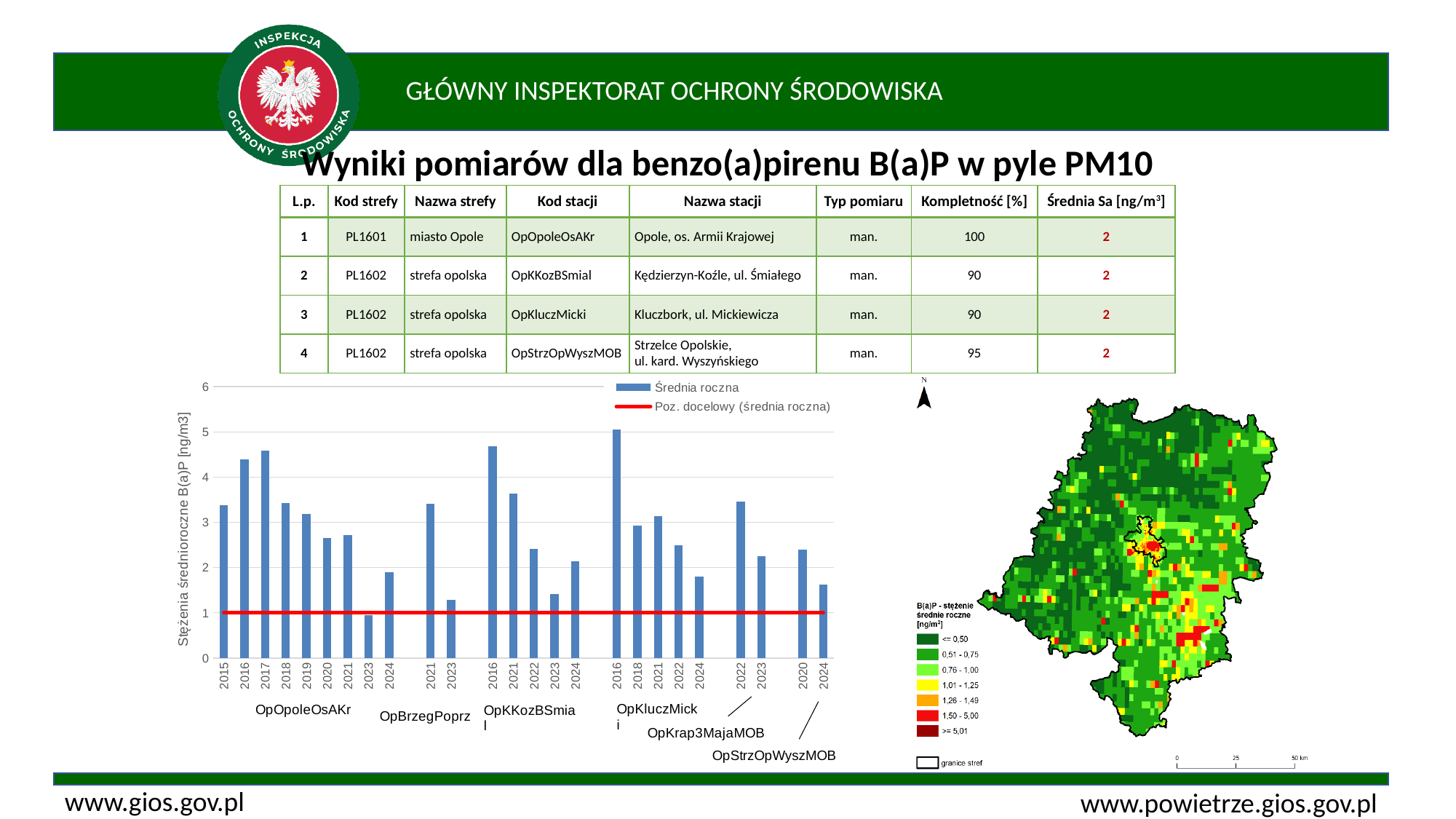
Is the value for OpStrzOpWyszMOB in 2024 greater or less than 2? less What kind of chart is shown on the slide? combination bar and line chart Is the value for OpKrap3MajaMOB in 2022 greater or less than 3? greater Is the value for OpKluczMicki in 2016 greater or less than 4? greater How many series does the chart legend list? 2 How many bars are plotted in the chart? 25 How many stations are labelled along the x axis of the chart? 6 At what level on the y axis is the red 'Poz. docelowy (średnia roczna)' line drawn? 1 Which bar is the lowest in the chart? OpOpoleOsAKr 2023 Do the values for OpOpoleOsAKr rise or fall from 2017 to 2023? fall Which is larger for OpKKozBSmial: the 2016 value or the 2021 value? 2016 Which bar is the highest in the chart? OpKluczMicki 2016